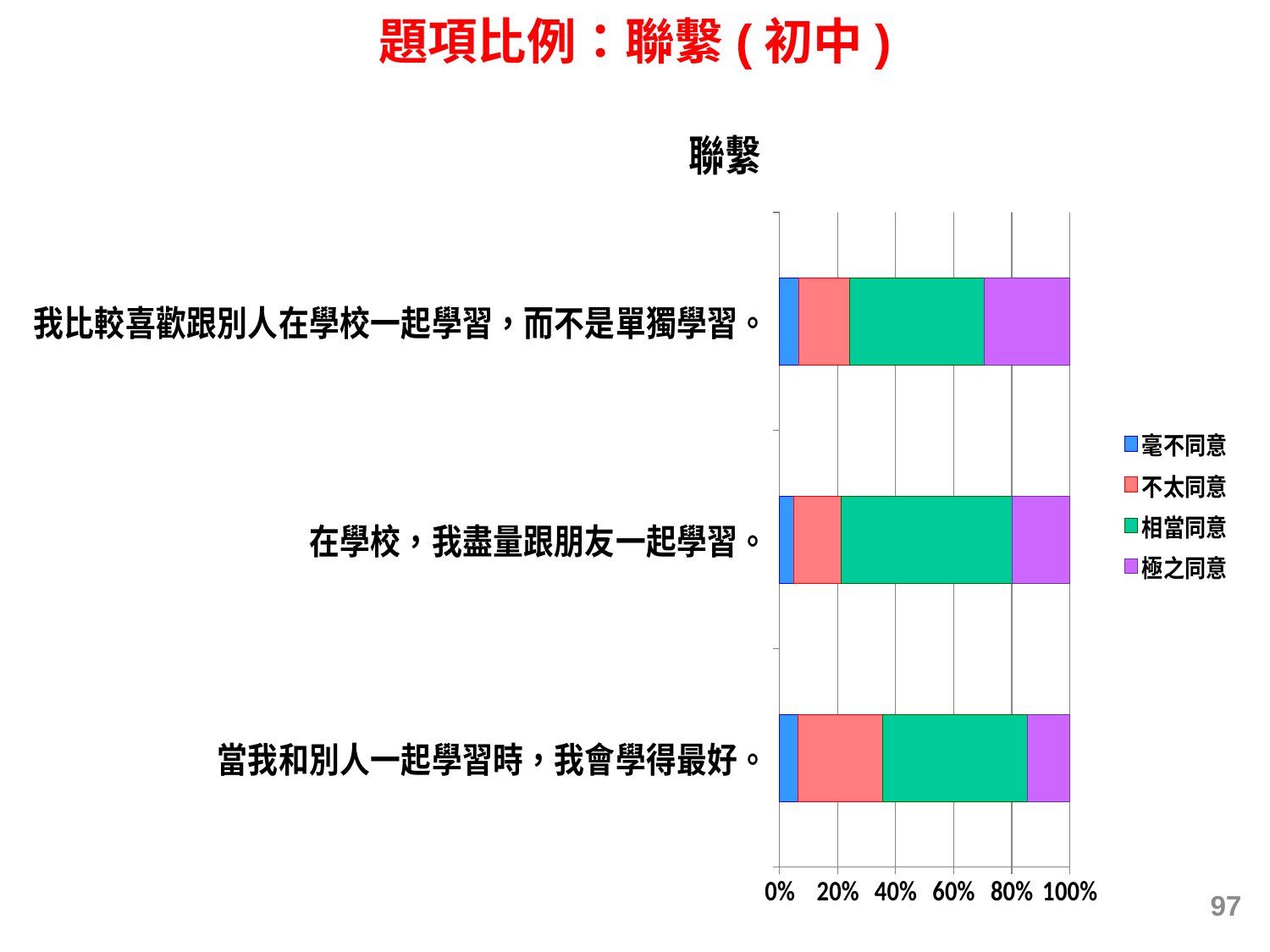
How many series does the legend list? 4 Is the 極之同意 share for 「當我和別人一起學習時，我會學得最好。」 greater or less than 20%? less Which statement has the largest 極之同意 share? 我比較喜歡跟別人在學校一起學習，而不是單獨學習。 What kind of chart is shown on the slide? stacked bar chart Is the 極之同意 share for 「我比較喜歡跟別人在學校一起學習，而不是單獨學習。」 greater or less than 20%? greater Which statement has the larger 不太同意 share: 「在學校，我盡量跟朋友一起學習。」 or 「當我和別人一起學習時，我會學得最好。」? 當我和別人一起學習時，我會學得最好。 Which statement has the smallest 極之同意 share? 當我和別人一起學習時，我會學得最好。 Which legend entry is shown in green? 相當同意 Is the 毫不同意 share for 「在學校，我盡量跟朋友一起學習。」 greater or less than 20%? less What is the total of each stacked bar, as read from the axis? 100% What is the title of the chart? 聯繫 How many statements (categories) are plotted in the chart? 3